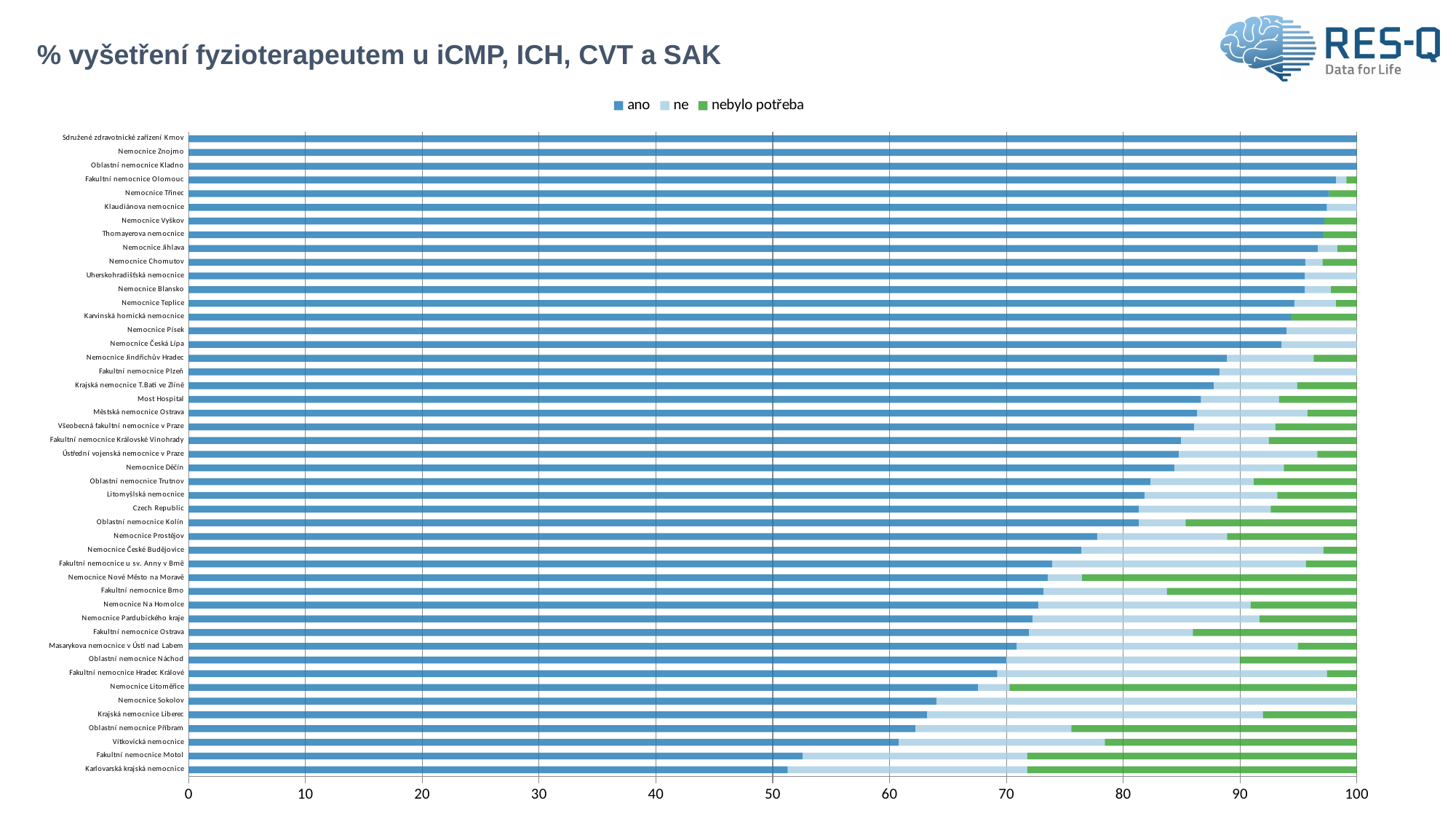
Which has a larger 'ano' value, Sdružené zdravotnické zařízení Krnov or Karlovarská krajská nemocnice? Sdružené zdravotnické zařízení Krnov Is the 'ano' value for Fakultní nemocnice Motol greater or less than 60? less What kind of chart is shown on the slide? bar chart What are the three series named in the legend? ano, ne, nebylo potřeba What is the title of the chart? % vyšetření fyzioterapeutem u iCMP, ICH, CVT a SAK Which has a larger 'ano' value, Nemocnice Sokolov or Fakultní nemocnice Motol? Nemocnice Sokolov Is the 'ano' value for Czech Republic greater or less than 70? greater Is the 'ano' value for Nemocnice Litoměřice greater or less than 70? less How many hospitals (categories) are listed on the vertical axis? 47 How many series does the legend list? 3